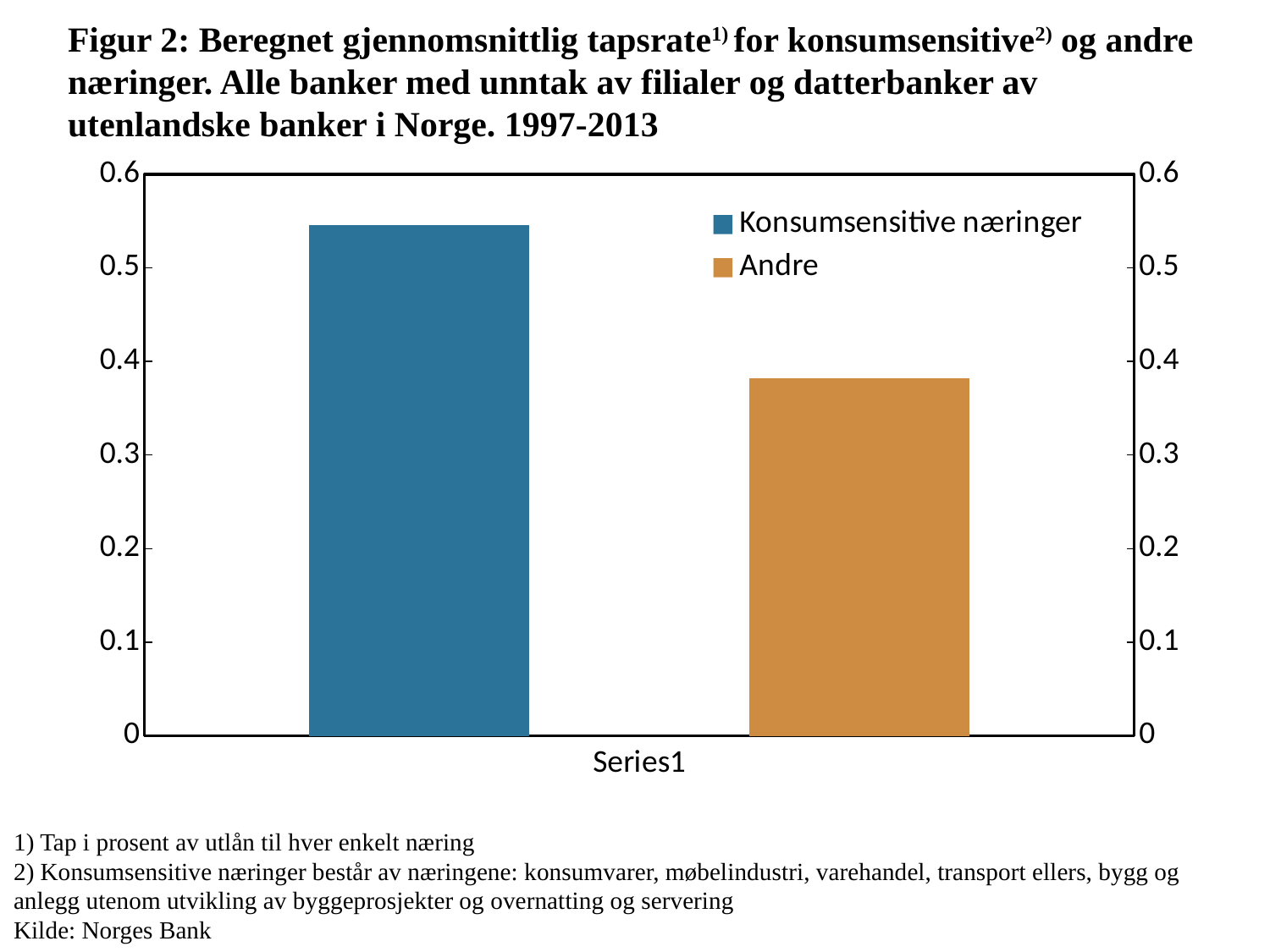
What is the label shown on the x axis under the bars? Series1 Which series has the higher bar, Konsumsensitive næringer or Andre? Konsumsensitive næringer What kind of chart is shown on the slide? bar chart What colour is the bar for Andre? orange Which series has the lowest value in the chart? Andre Is the value for Konsumsensitive næringer greater or less than 0.6? less How many series does the legend list? 2 Which series has the highest value in the chart? Konsumsensitive næringer What is the highest value shown on the y axis? 0.6 Is the value for Andre greater or less than 0.4? less Is the value for Andre greater or less than 0.3? greater